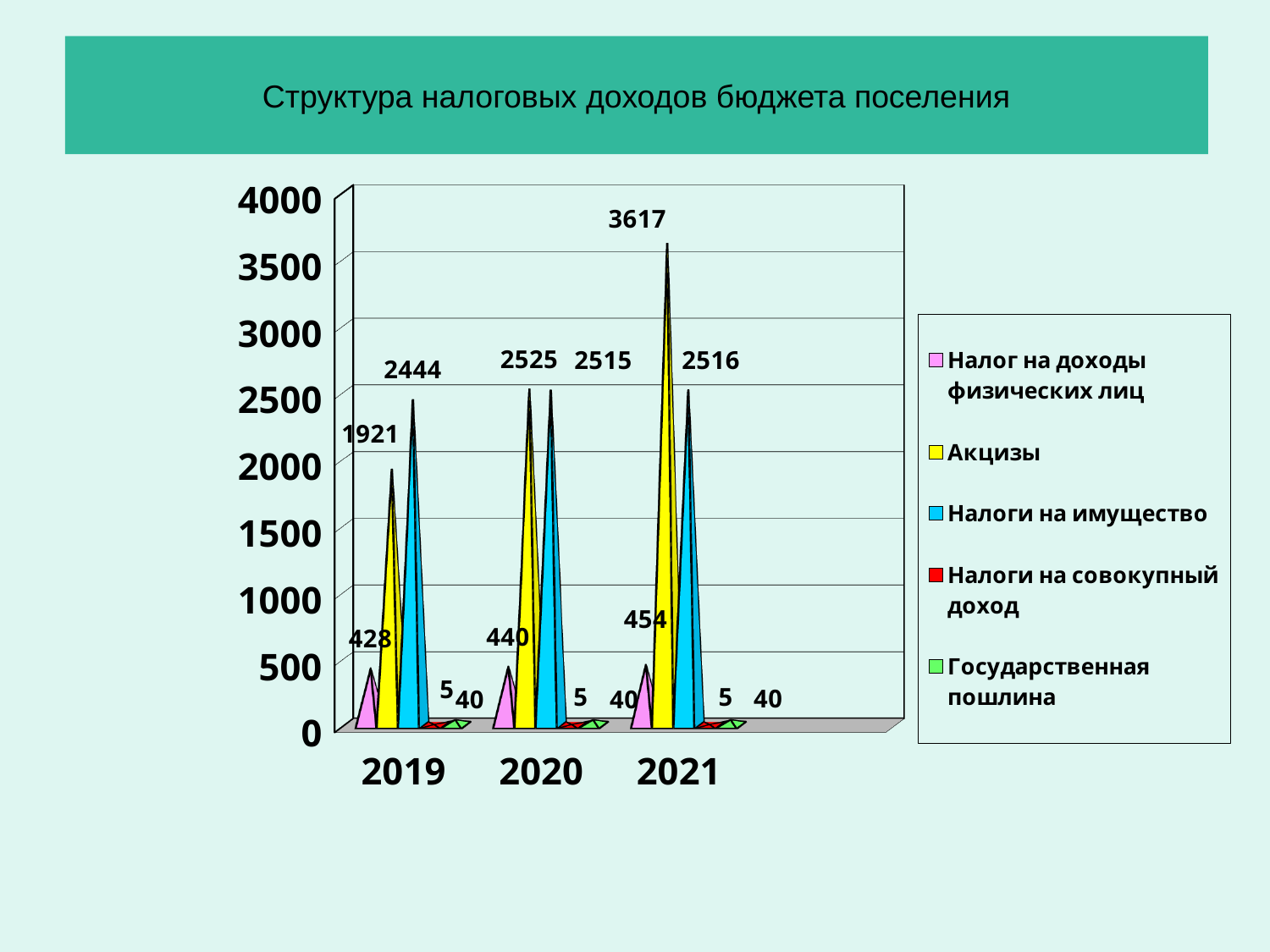
What is the value of Акцизы for 2019? 1921 Which is larger in 2019: Акцизы or Налоги на имущество? Налоги на имущество What is the value of Налоги на имущество for 2020? 2515 What kind of chart is shown on the slide? Bar chart In which year is Акцизы highest? 2021 How many series does the legend list? 5 What is the value of Акцизы for 2021? 3617 Does the value of Налог на доходы физических лиц rise or fall from 2019 to 2021? Rise What is the difference between Акцизы in 2021 and Акцизы in 2020? 1092 What is the value of Налог на доходы физических лиц for 2019? 428 How many years are shown on the x axis? 3 Which series has the lowest value in 2020? Налоги на совокупный доход